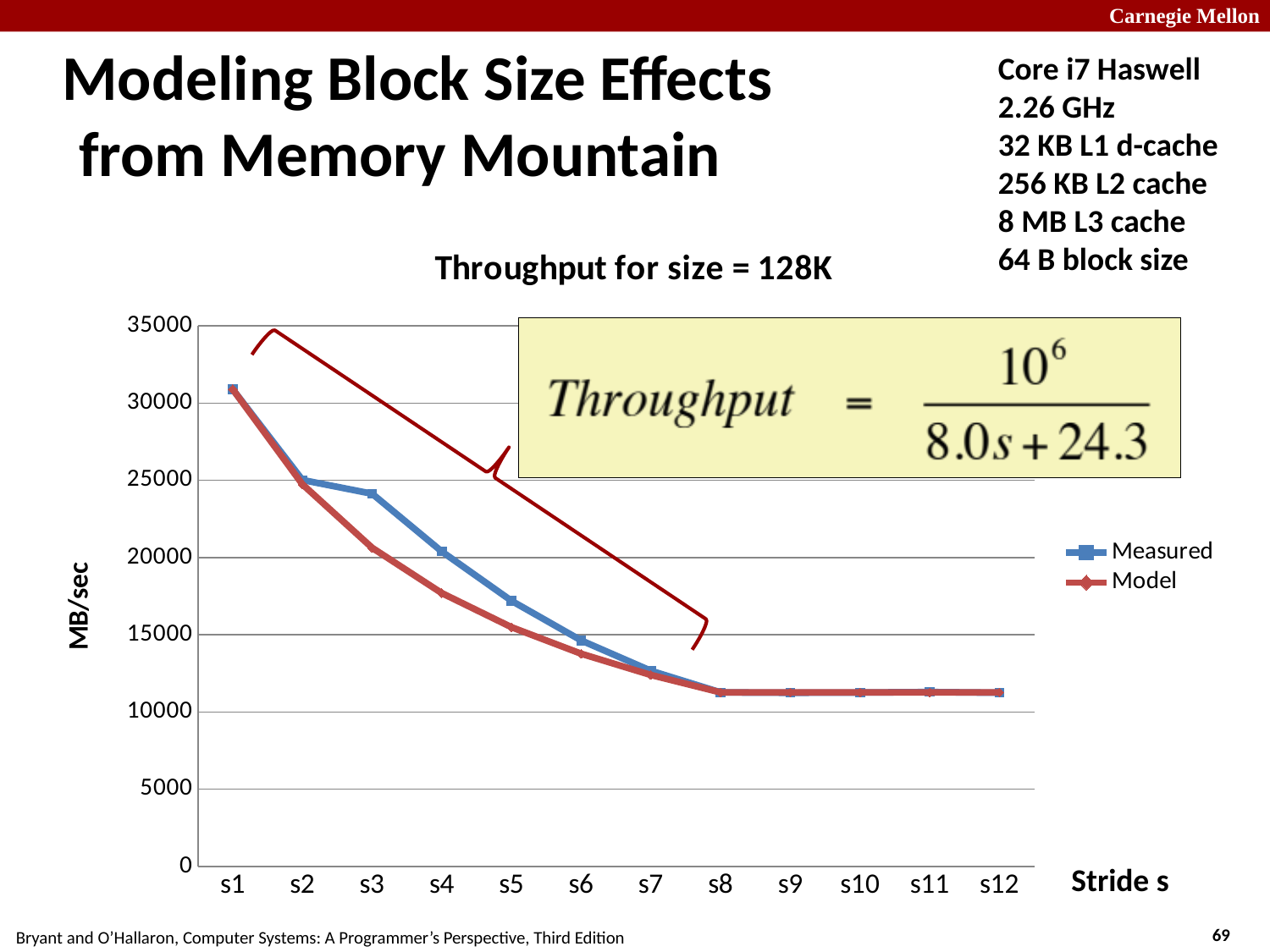
Do the Measured values rise or fall as the stride increases from s1 to s8? fall Is the Measured value at s2 greater or less than 20000? greater What kind of chart is shown on the slide? line chart Is the Measured value at s1 greater or less than 25000? greater What is the title of the chart? Throughput for size = 128K What are the two series named in the chart's legend? Measured and Model How many stride values are plotted along the x axis? 12 Is the Model value at s4 greater or less than 20000? less At stride s3, which series has the larger value, Measured or Model? Measured At which stride is the Measured throughput highest? s1 How many series does the chart's legend list? 2